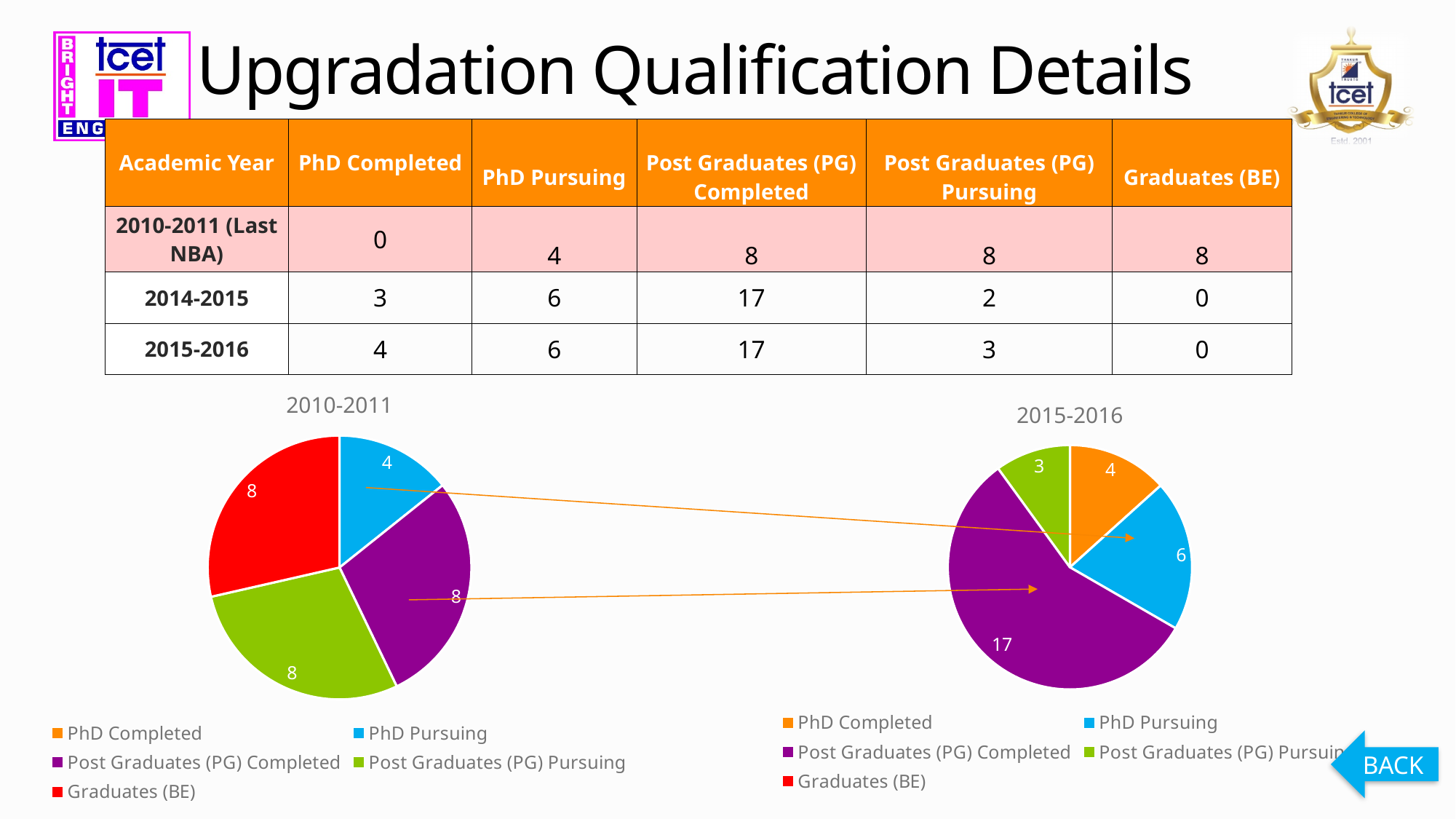
In the 2015-2016 pie chart, which category has the largest slice? Post Graduates (PG) Completed What kind of chart is used for the 2010-2011 and 2015-2016 data? Pie chart In the 2015-2016 pie chart, what is the value for Post Graduates (PG) Pursuing? 3 In the 2010-2011 pie chart, what is the value for Graduates (BE)? 8 In the 2015-2016 pie chart, what is the value for Post Graduates (PG) Completed? 17 How many entries does the legend of the 2015-2016 pie chart list? 5 In the 2010-2011 pie chart, what is the value for PhD Pursuing? 4 How many slices are visible in the 2010-2011 pie chart? 4 In the 2015-2016 pie chart, which of the slices shown is the smallest? Post Graduates (PG) Pursuing In the 2010-2011 pie chart, which of the slices shown is the smallest? PhD Pursuing In the 2015-2016 pie chart, what is the difference between Post Graduates (PG) Completed and PhD Pursuing? 11 In the 2015-2016 pie chart, which is larger: PhD Completed or PhD Pursuing? PhD Pursuing